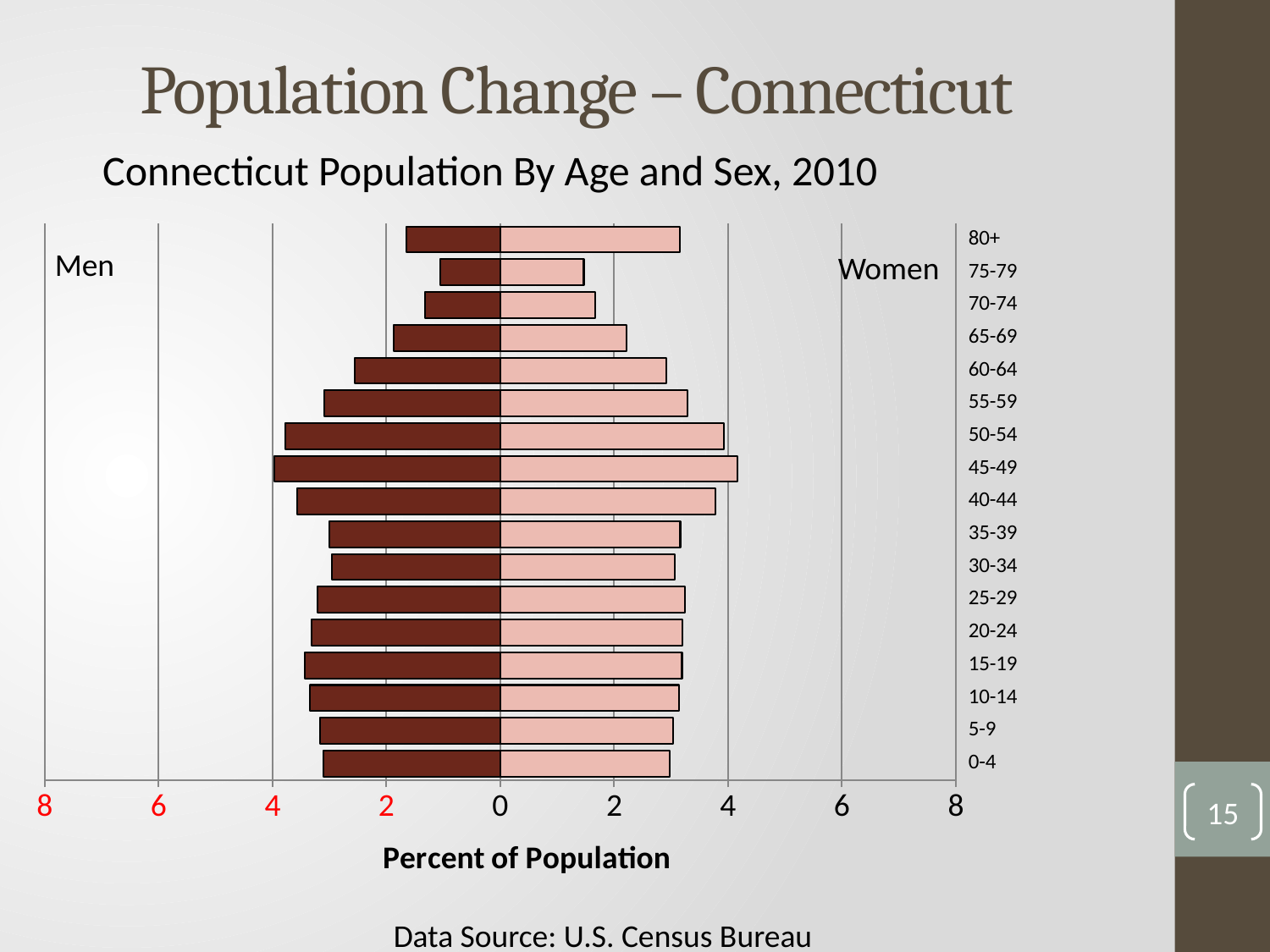
Is the value for Women aged 80+ greater or less than 2? greater How many age groups are shown on the chart? 17 How many groups (sexes) does the chart plot? 2 Which age group has the longest bar for Men? 45-49 Which age group has the shortest bar for Men? 75-79 Which age group has the longest bar for Women? 45-49 Is the value for Men aged 80+ greater or less than 2? less For the 80+ age group, which is larger, the value for Men or for Women? Women What is the title of the chart? Connecticut Population By Age and Sex, 2010 Is the value for Men aged 50-54 greater or less than 2? greater What kind of chart is shown on the slide? bar chart